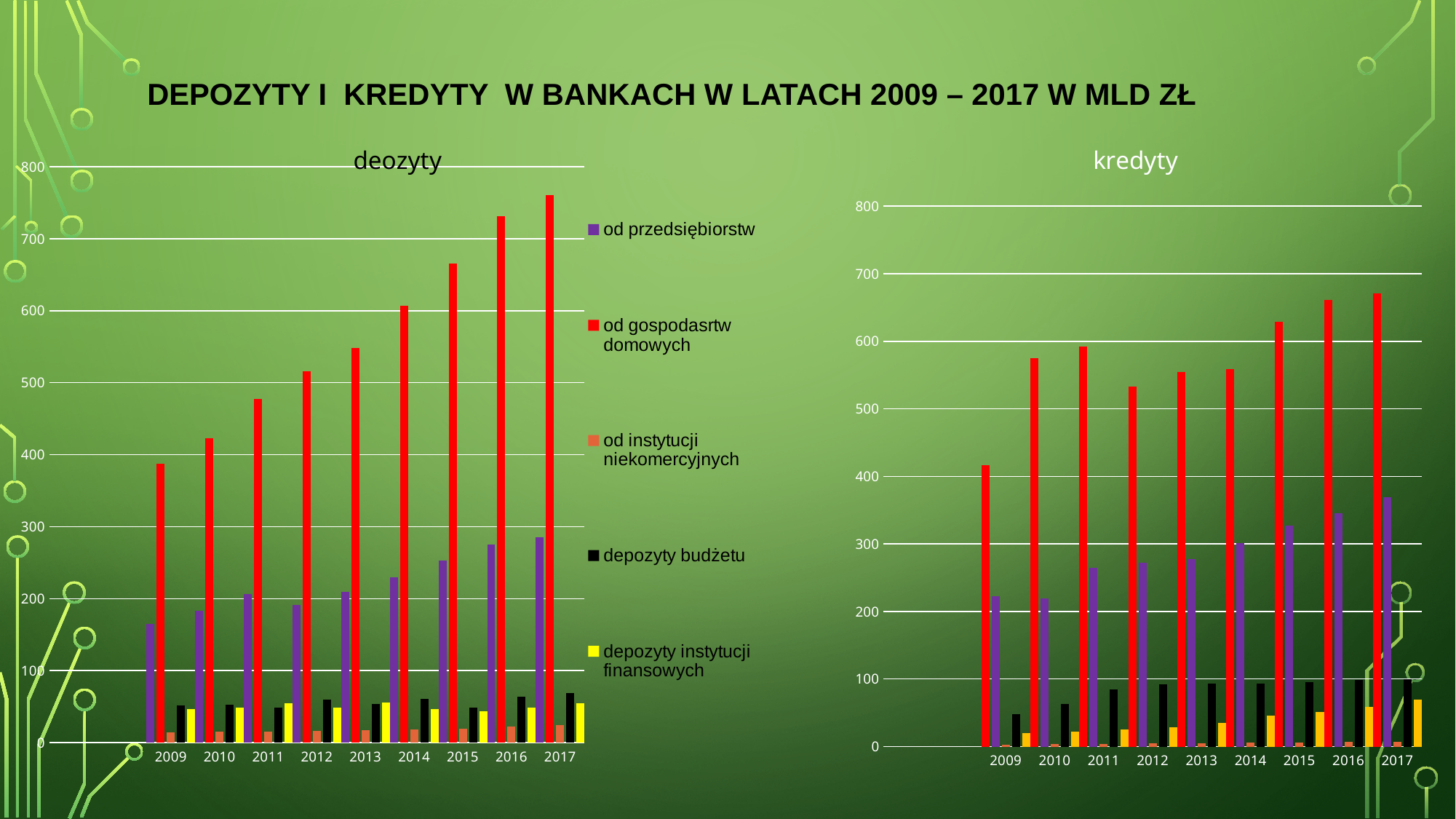
What colour represents 'depozyty instytucji finansowych' in the 'deozyty' chart legend? yellow In the 'kredyty' chart, is the red bar for 2011 larger or smaller than the red bar for 2012? larger In the 'deozyty' chart, is the value for 'od gospodasrtw domowych' in 2009 greater or less than 400? less In the 'deozyty' chart, which year has the highest value for 'od gospodasrtw domowych'? 2017 What kind of chart is the 'deozyty' chart on the left? bar chart In the 'deozyty' chart, do the values for 'od gospodasrtw domowych' rise or fall from 2009 to 2017? rise In the 'kredyty' chart, is the tallest red bar in 2017 greater or less than 600? greater In the 'kredyty' chart, is the purple bar for 2017 greater or less than 300? greater In the 'deozyty' chart, which year has the lowest value for 'od przedsiębiorstw'? 2009 How many years are shown on the x axis of the 'kredyty' chart? 9 How many series does the legend of the 'deozyty' chart list? 5